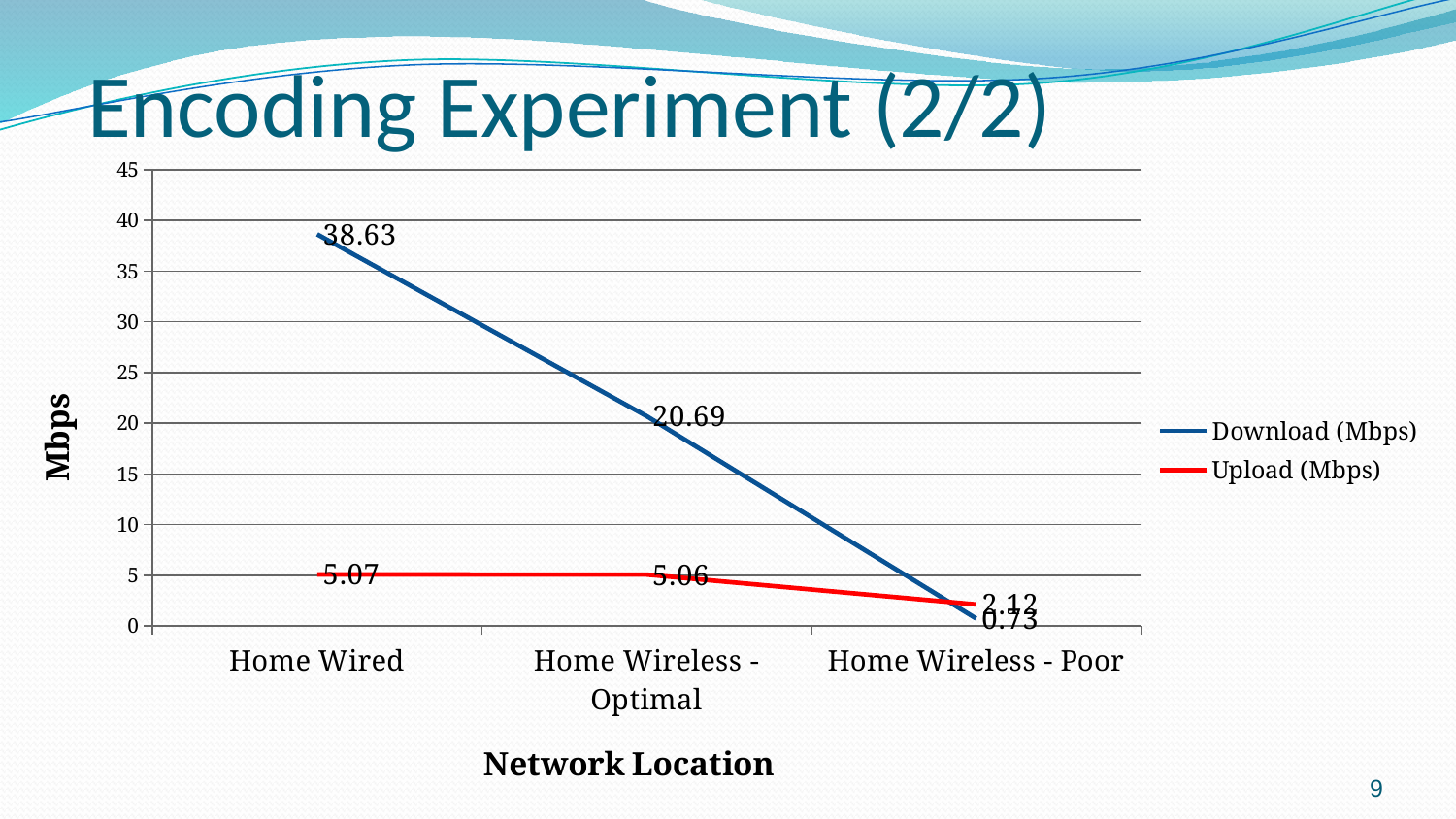
How many network locations are shown on the x axis? 3 Which is larger at Home Wireless - Optimal: the Download (Mbps) value or the Upload (Mbps) value? Download (Mbps) What is the difference between the Download (Mbps) values for Home Wired and Home Wireless - Optimal? 17.94 What is the Upload (Mbps) value for Home Wireless - Poor? 2.12 Which network location has the highest Download (Mbps) value? Home Wired What is the Download (Mbps) value for Home Wired? 38.63 What is the Upload (Mbps) value for Home Wireless - Optimal? 5.06 What is the Download (Mbps) value for Home Wireless - Poor? 0.73 Does the Download (Mbps) series rise or fall from Home Wired to Home Wireless - Poor? Fall What kind of chart is shown on the slide? Line chart Which network location has the lowest Upload (Mbps) value? Home Wireless - Poor How many series does the legend list? 2